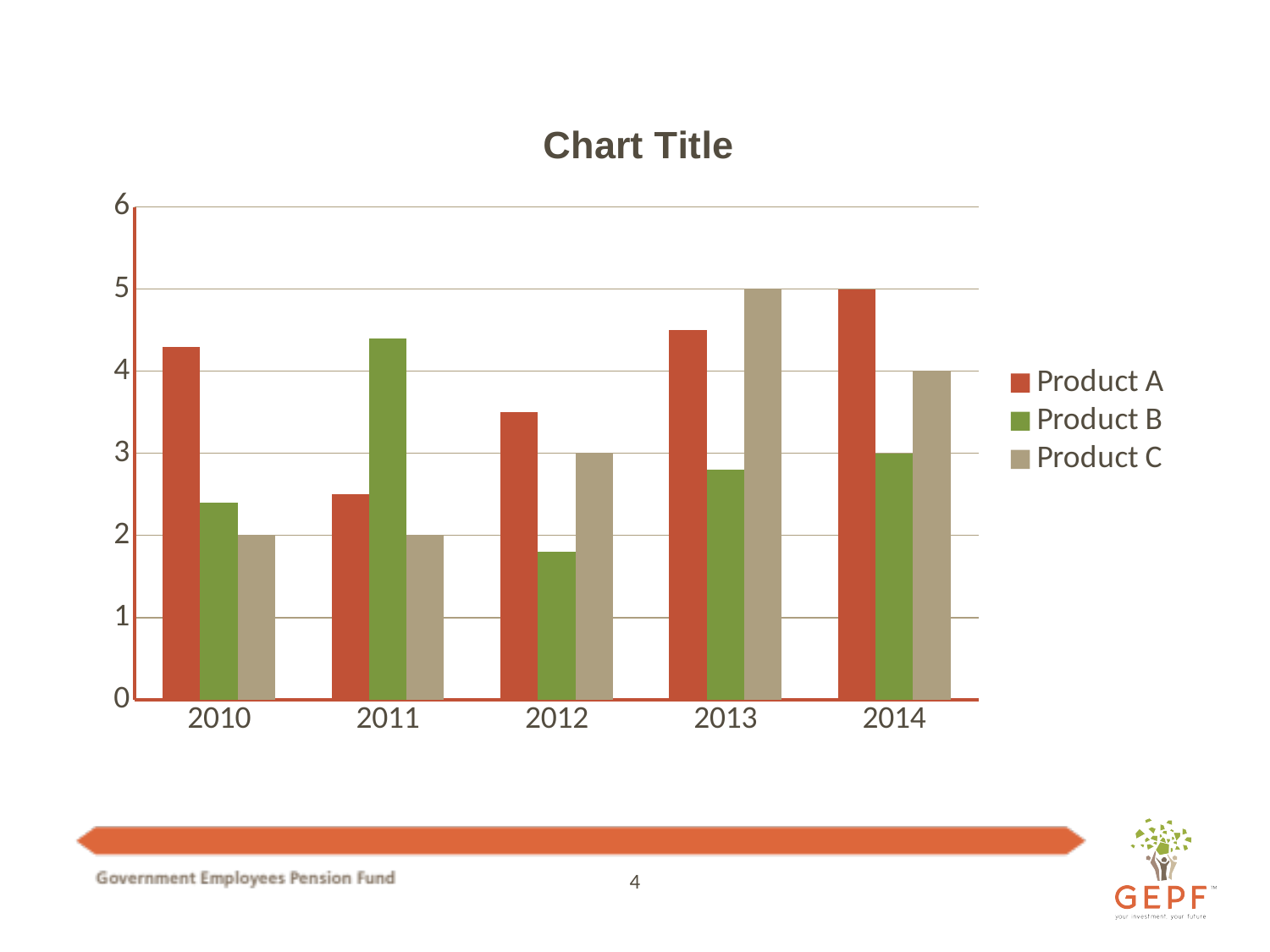
What is the difference between Product C in 2014 and Product C in 2010? 2 What is the value for Product C in 2013? 5 What kind of chart is shown on the slide? bar chart How many years are shown on the x axis? 5 What is the value for Product A in 2014? 5 Is the value for Product A in 2010 greater or less than 4? greater Is the value for Product B in 2012 greater or less than 2? less In which year is Product A lowest? 2011 What is the value for Product C in 2010? 2 Which is larger in 2011, Product A or Product B? Product B In which year is Product C highest? 2013 How many series does the legend list? 3